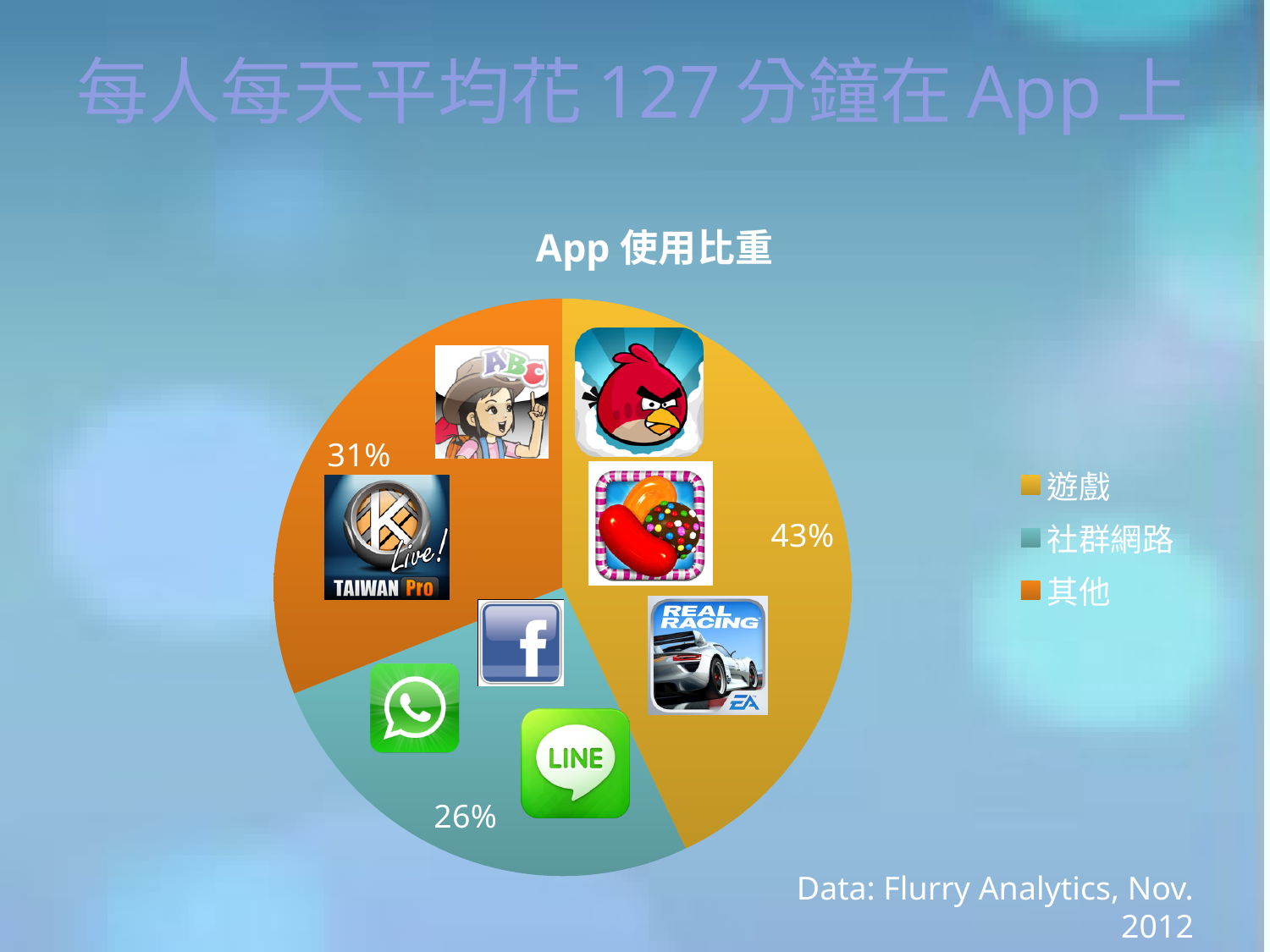
How many entries does the legend list? 3 What share of the pie does 社群網路 (social networking) take? 26% Which category has the smallest slice of the pie? 社群網路 What share of the pie does 其他 (other) take? 31% Which category has the largest slice of the pie? 遊戲 What type of chart is shown on the slide? pie chart What is the difference in percentage points between 遊戲 and 社群網路? 17% How many categories does the pie chart have? 3 What is the title of the chart? App 使用比重 Which is larger, the share for 其他 or the share for 社群網路? 其他 What share of the pie does 遊戲 (games) take? 43% What colour represents 遊戲 in the legend? yellow